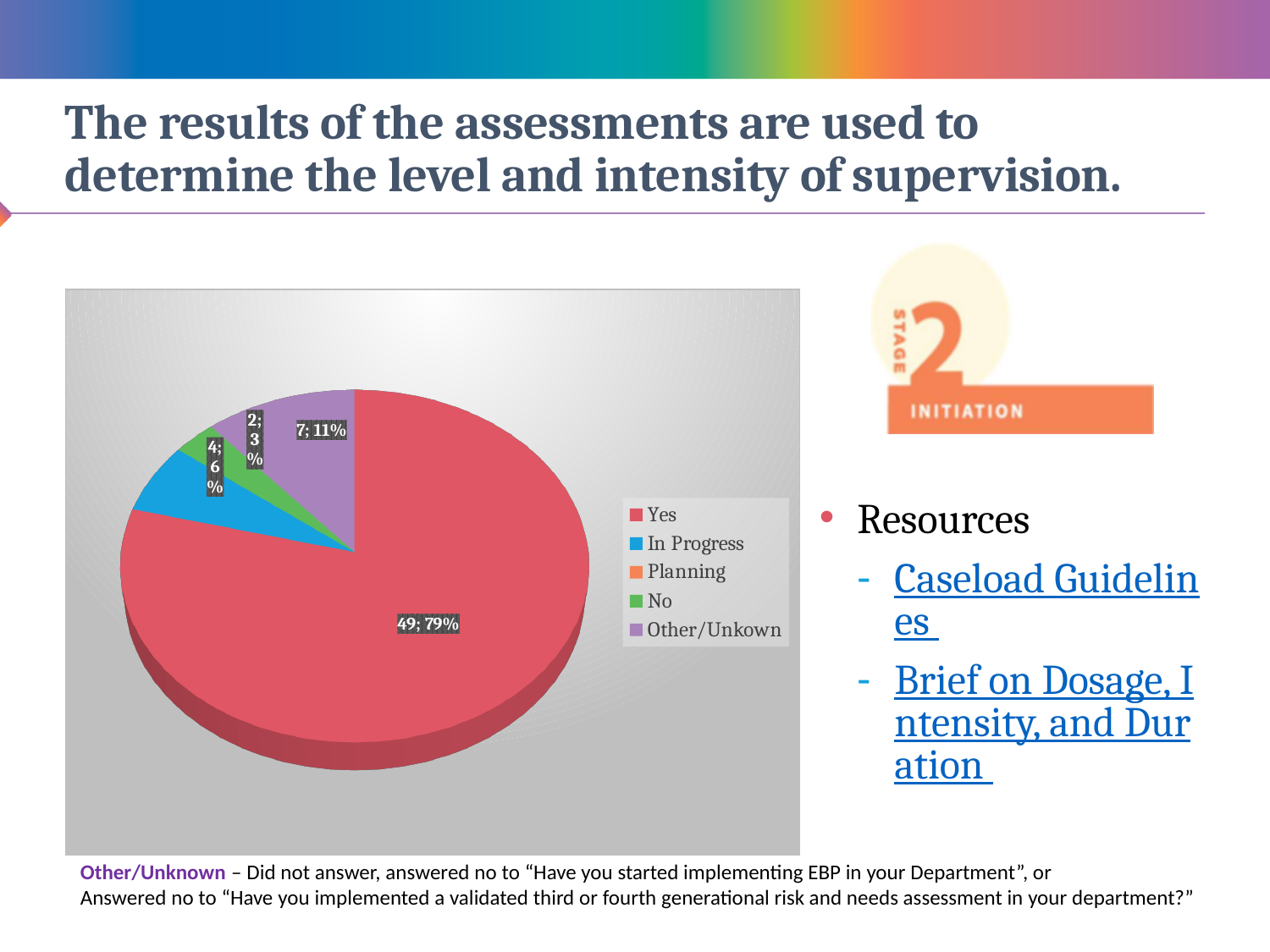
Which category has the largest slice in the pie chart? Yes How many entries does the legend of the pie chart list? 5 What colour is the Yes slice in the pie chart? red What count is shown for the In Progress slice? 4 Among the labelled slices, which category has the smallest slice? No What is the data label shown on the Other/Unkown slice? 7; 11% What percentage share does the No slice represent? 3% What is the difference between the count for Yes and the count for Other/Unkown? 42 What percentage share does the Yes slice represent? 79% Which slice is larger, In Progress or No? In Progress What is the data label shown on the Yes slice of the pie chart? 49; 79% What kind of chart is shown on the slide? pie chart